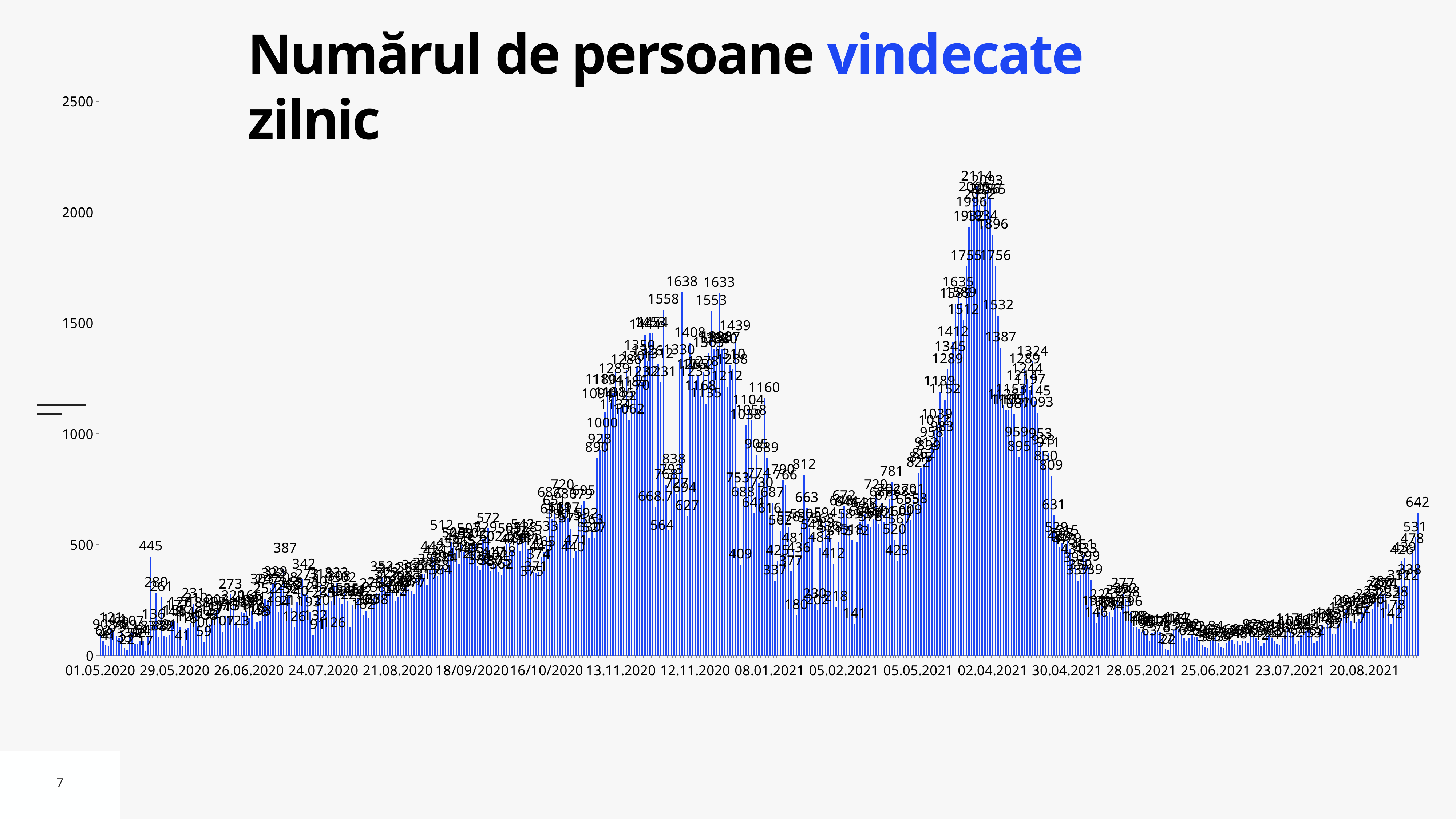
Do the values rise or fall from the 20.08.2021 axis label to the right end of the chart? rise What is the value labelled on the isolated tall bar just before the 29.05.2020 axis label? 445 What is the highest value labelled in the November 2020 peak of the chart? 1638 What is the highest value labelled on the chart? 2114 What kind of chart is shown on the slide? bar chart What is the difference between the overall peak value 2114 and the November 2020 peak value 1638? 476 What is the value labelled on the last bar at the right end of the chart? 642 What is the title of the chart? Numărul de persoane vindecate zilnic Which is larger: the peak value of the November 2020 wave (1638) or the peak value of the April 2021 wave (2114)? 2114 What is the maximum value shown on the vertical axis? 2500 Is the highest bar on the chart greater or less than 2000? greater Is the value of the last bar on the chart greater or less than 500? greater